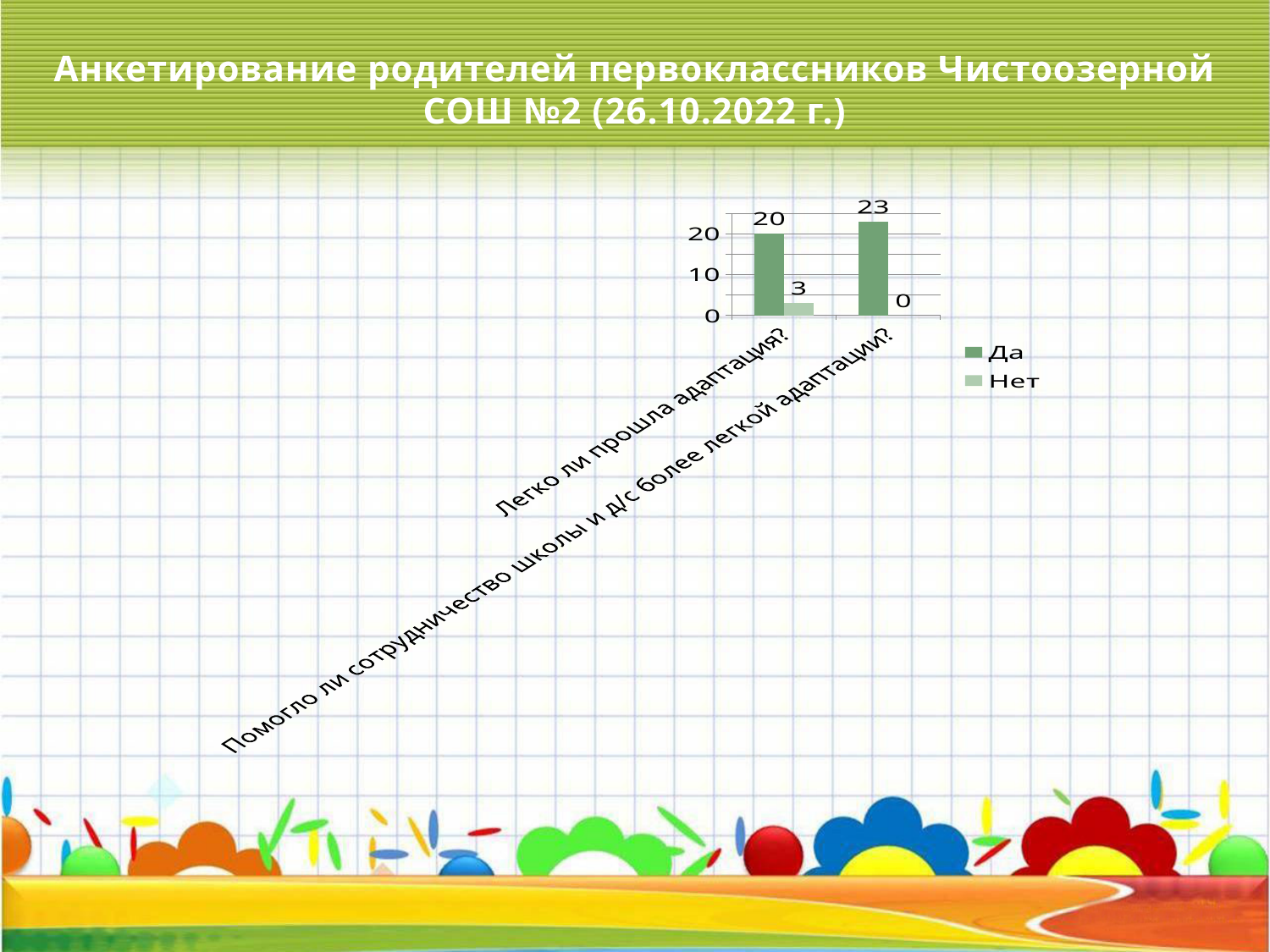
What is the value of "Нет" for "Легко ли прошла адаптация?"? 3 How many series does the legend list? 2 What is the value of "Нет" for "Помогло ли сотрудничество школы и д/с более легкой адаптации?"? 0 What is the difference between the "Да" values of the two categories? 3 What is the difference between the "Да" and "Нет" values for "Легко ли прошла адаптация?"? 17 How many categories are shown on the x axis? 2 What is the value of "Да" for "Помогло ли сотрудничество школы и д/с более легкой адаптации?"? 23 What are the two series named in the legend? Да, Нет What is the value of "Да" for "Легко ли прошла адаптация?"? 20 What type of chart is shown on the slide? bar chart Which category has the highest "Да" value? Помогло ли сотрудничество школы и д/с более легкой адаптации? Which is larger: the "Да" value for "Легко ли прошла адаптация?" or the "Да" value for "Помогло ли сотрудничество школы и д/с более легкой адаптации?"? Помогло ли сотрудничество школы и д/с более легкой адаптации?